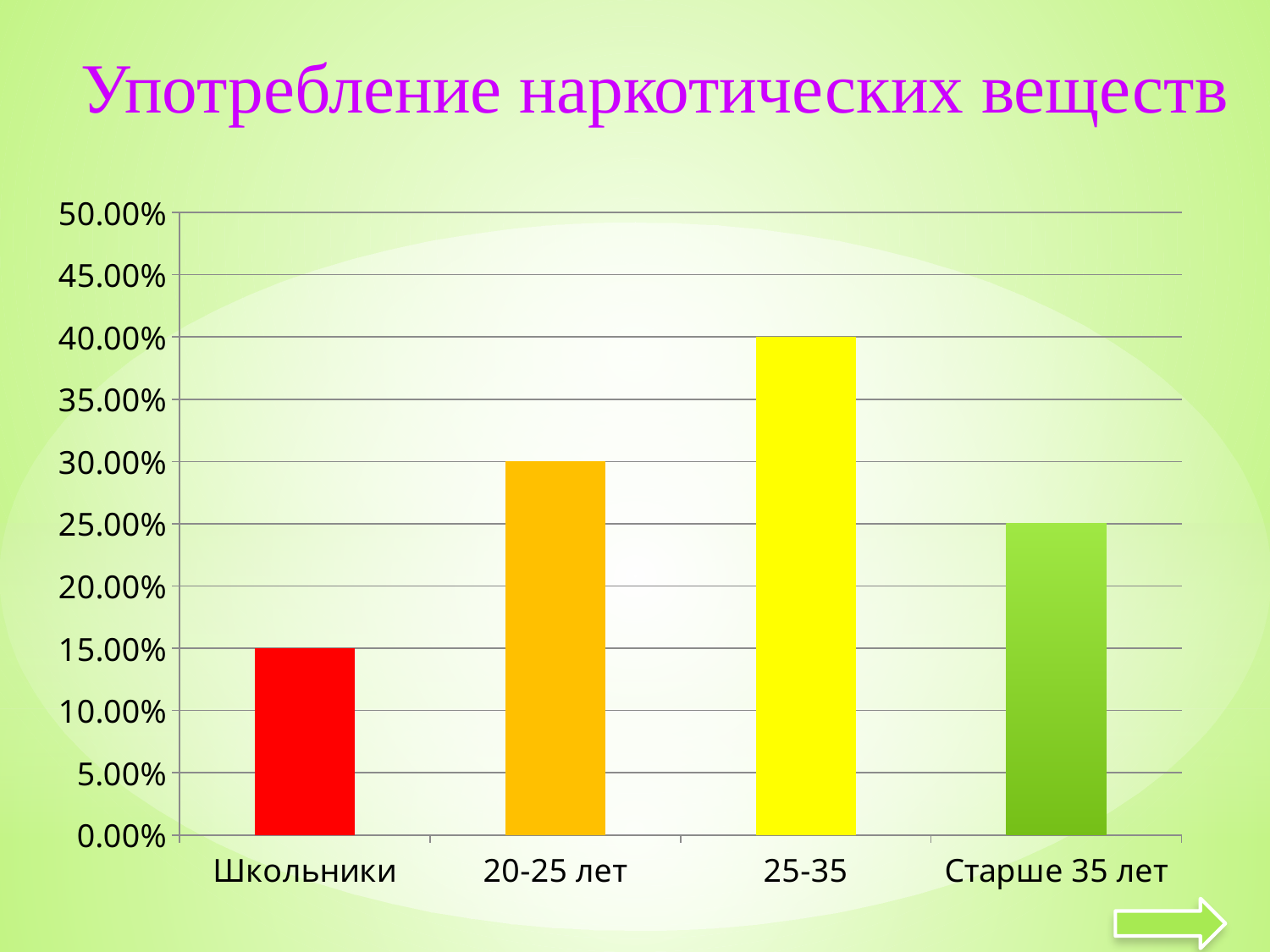
What is the difference between the values for 20-25 лет and Старше 35 лет? 5.00% Which category has the highest value? 25-35 What is the value for 25-35? 40.00% What is the value for Школьники? 15.00% What is the difference between the values for 25-35 and Школьники? 25.00% What is the value for Старше 35 лет? 25.00% How many categories are shown on the x axis? 4 Which is larger, the value for 20-25 лет or the value for Старше 35 лет? 20-25 лет What is the value for 20-25 лет? 30.00% What is the title of the slide? Употребление наркотических веществ What kind of chart is shown on the slide? Bar chart Which category has the lowest value? Школьники